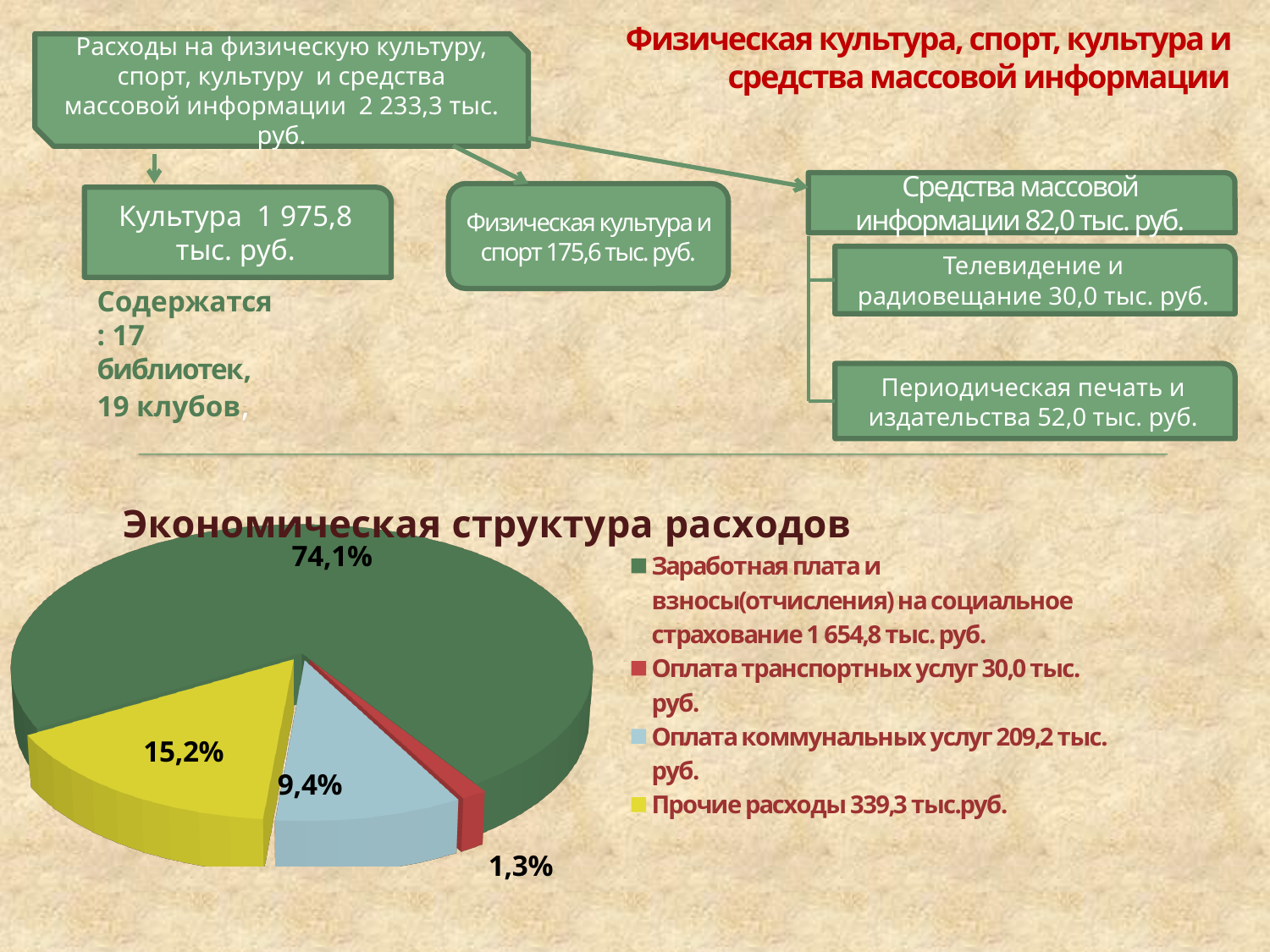
Which category has the largest slice in the pie chart? Заработная плата и взносы(отчисления) на социальное страхование Which category has the smallest slice in the pie chart? Оплата транспортных услуг Which slice is larger: "Прочие расходы" or "Оплата коммунальных услуг"? Прочие расходы What kind of chart is shown under the title "Экономическая структура расходов"? pie chart What share of the pie does "Заработная плата и взносы(отчисления) на социальное страхование" take? 74,1% How many entries does the legend of the pie chart list? 4 What share of the pie does "Оплата транспортных услуг" take? 1,3% What share of the pie does "Оплата коммунальных услуг" take? 9,4% How many slices does the pie chart "Экономическая структура расходов" have? 4 What colour is the slice for "Прочие расходы" in the pie chart? yellow What is the difference in percentage points between the "Прочие расходы" slice and the "Оплата коммунальных услуг" slice? 5,8